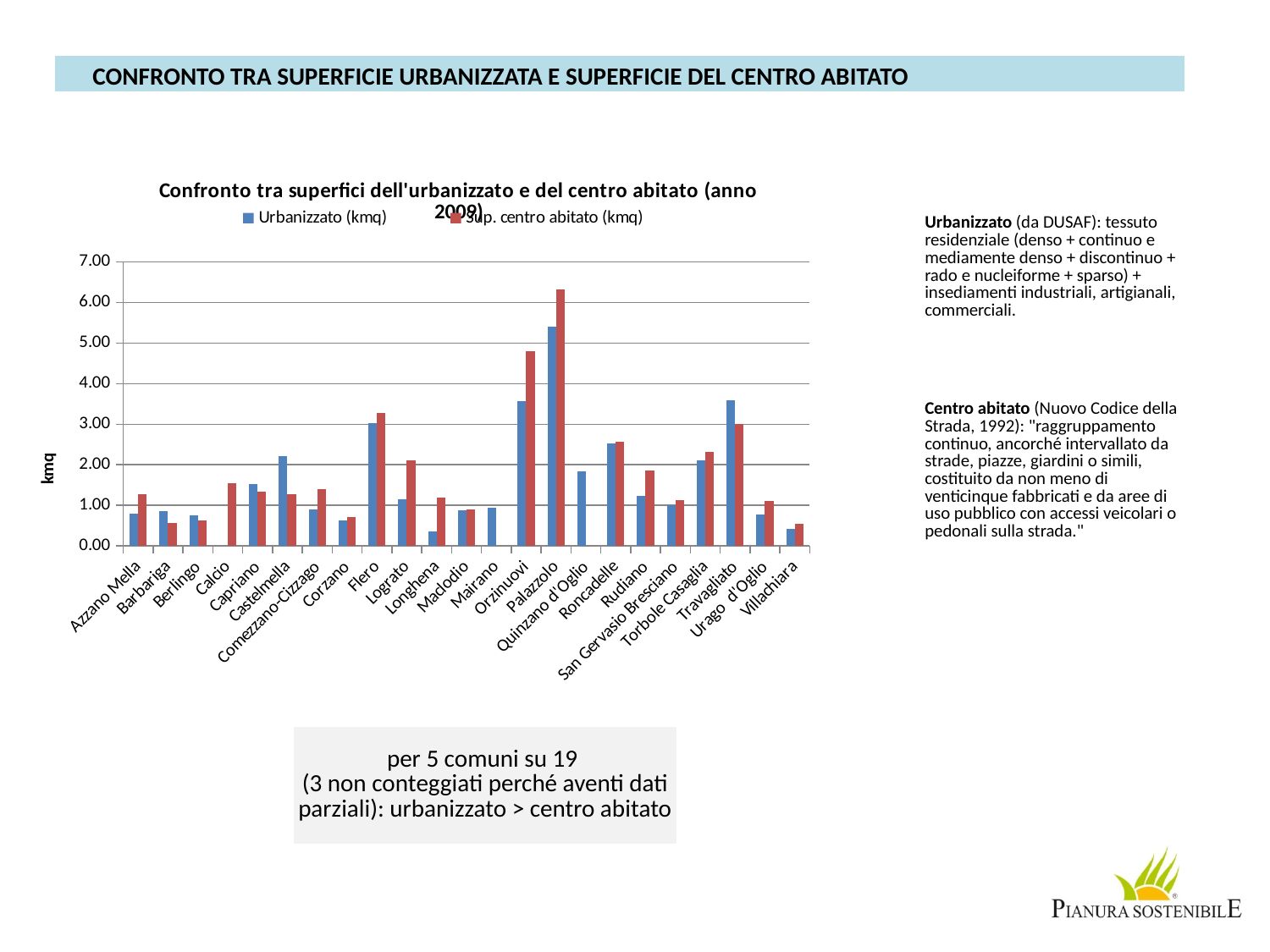
What is the label on the vertical axis of the chart? kmq Is the Sup. centro abitato (kmq) value for Orzinuovi greater or less than 4.00? greater How many series does the chart legend list? 2 Which municipality has the highest value for Urbanizzato (kmq)? Palazzolo Is the Urbanizzato (kmq) value for Travagliato greater or less than 3.00? greater Is the Urbanizzato (kmq) value for Longhena greater or less than 1.00? less For Lograto, which is larger: Urbanizzato (kmq) or Sup. centro abitato (kmq)? Sup. centro abitato (kmq) What kind of chart is shown on the slide? bar chart For Travagliato, which is larger: Urbanizzato (kmq) or Sup. centro abitato (kmq)? Urbanizzato (kmq) Which municipality has the highest value for Sup. centro abitato (kmq)? Palazzolo How many municipalities (categories) are shown on the x axis of the chart? 23